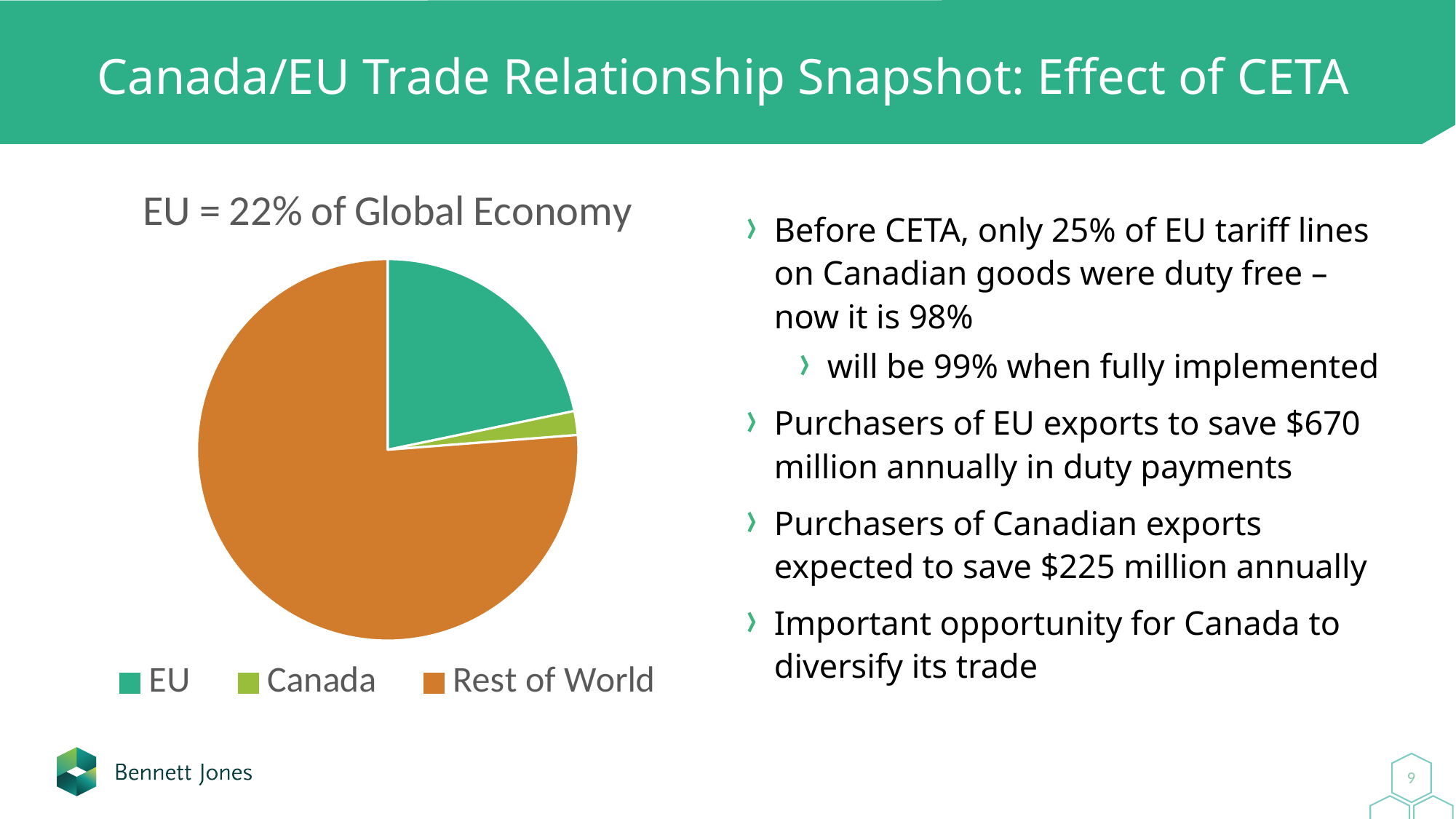
Which slice of the pie chart is the smallest? Canada Which is larger in the pie chart, the EU slice or the Canada slice? EU Which is larger in the pie chart, the Rest of World slice or the EU slice? Rest of World What share of the global economy does the EU slice represent, according to the chart title? 22% What is the title of the pie chart? EU = 22% of Global Economy How many slices does the pie chart have? 3 What kind of chart is shown on the slide? pie chart Which slice of the pie chart is the largest? Rest of World How many entries does the pie chart's legend list? 3 What colour is the Rest of World slice in the pie chart? orange